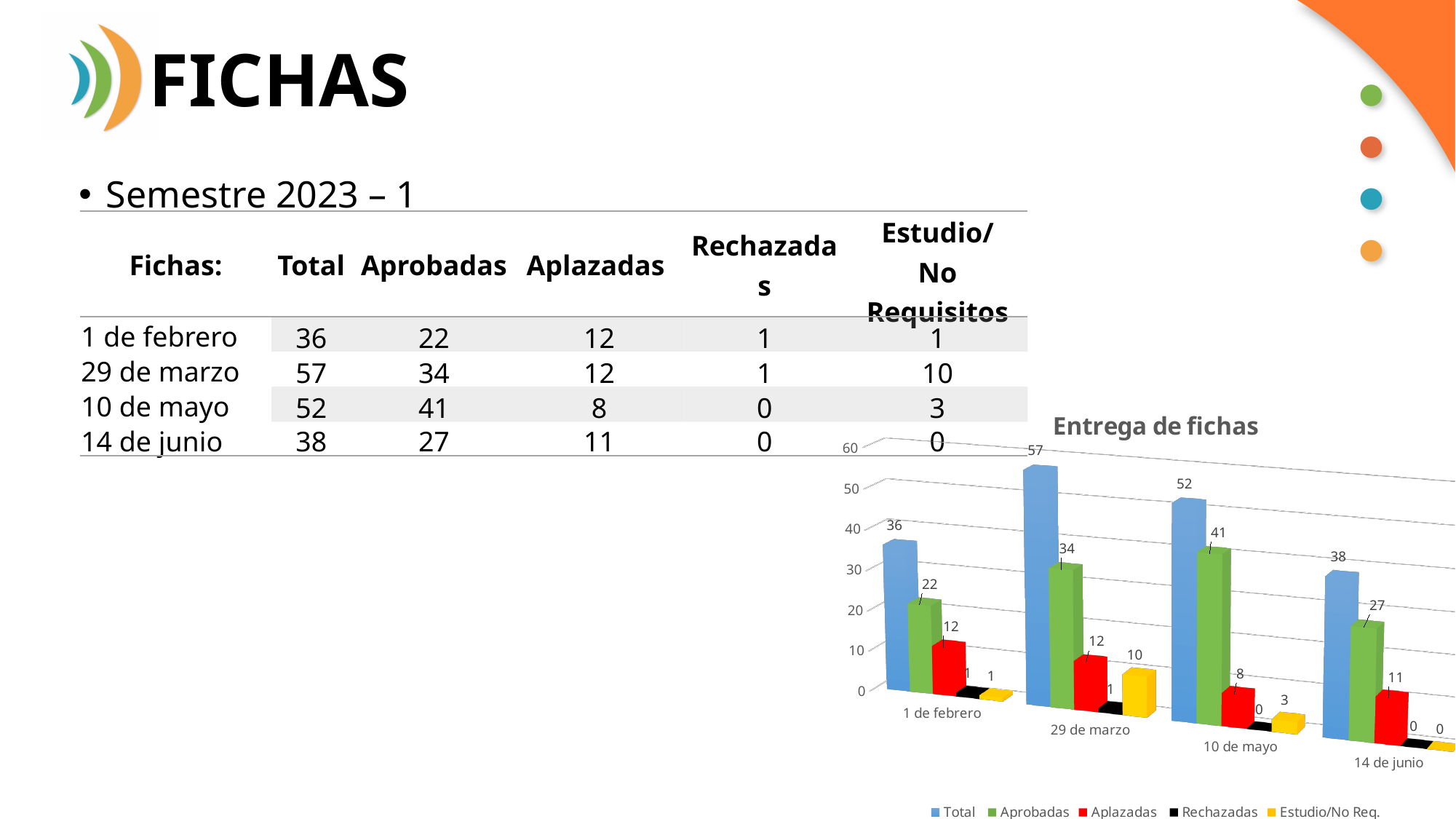
Which is larger, the Aplazadas value for 10 de mayo or for 14 de junio? 14 de junio What is the Estudio/No Req. value for 29 de marzo in the chart? 10 Which series is shown in red in the chart? Aplazadas Which date has the highest Total value in the chart? 29 de marzo How many date categories are shown on the x axis of the chart? 4 Which date has the lowest Aprobadas value in the chart? 1 de febrero What is the Total value for 29 de marzo in the chart? 57 What is the title of the chart? Entrega de fichas What is the Aprobadas value for 10 de mayo in the chart? 41 What type of chart is shown on the slide? bar chart What is the difference between the Total values for 29 de marzo and 1 de febrero? 21 How many series does the chart legend list? 5